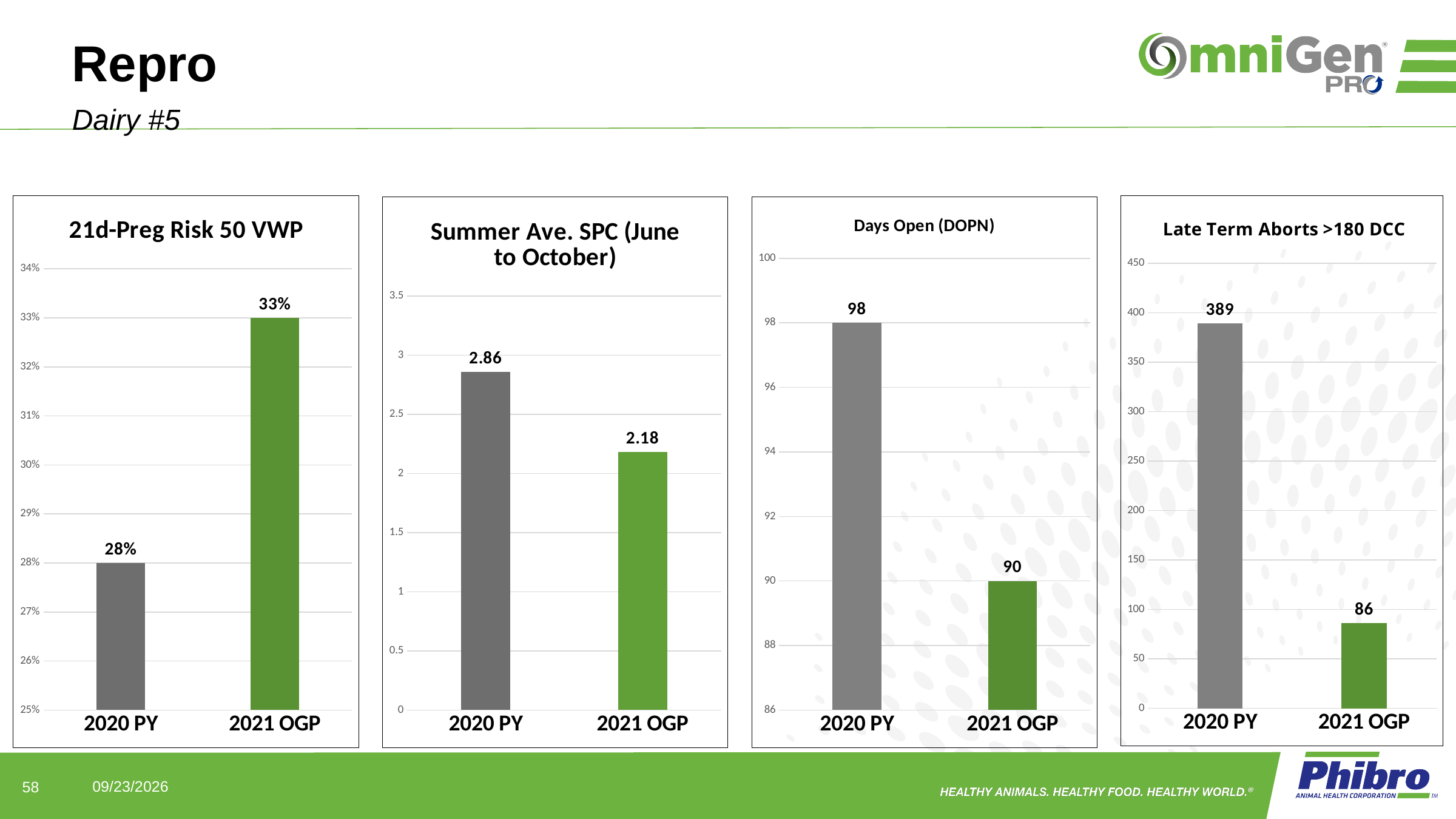
In the 'Summer Ave. SPC (June to October)' chart, what is the value for 2020 PY? 2.86 In the 'Summer Ave. SPC (June to October)' chart, what is the difference between the 2020 PY and 2021 OGP values? 0.68 In the 'Summer Ave. SPC (June to October)' chart, which category has the lowest value? 2021 OGP What kind of chart is the 'Days Open (DOPN)' chart? Bar chart In the '21d-Preg Risk 50 VWP' chart, what is the value for 2020 PY? 28% In the 'Days Open (DOPN)' chart, which is larger, 2020 PY or 2021 OGP? 2020 PY In the 'Late Term Aborts >180 DCC' chart, what is the value for 2020 PY? 389 How many charts are shown on the slide? 4 In the '21d-Preg Risk 50 VWP' chart, what is the value for 2021 OGP? 33% In the '21d-Preg Risk 50 VWP' chart, what is the difference between the 2021 OGP and 2020 PY values? 5% In the 'Days Open (DOPN)' chart, what is the value for 2021 OGP? 90 In the 'Late Term Aborts >180 DCC' chart, what is the difference between the 2020 PY and 2021 OGP values? 303